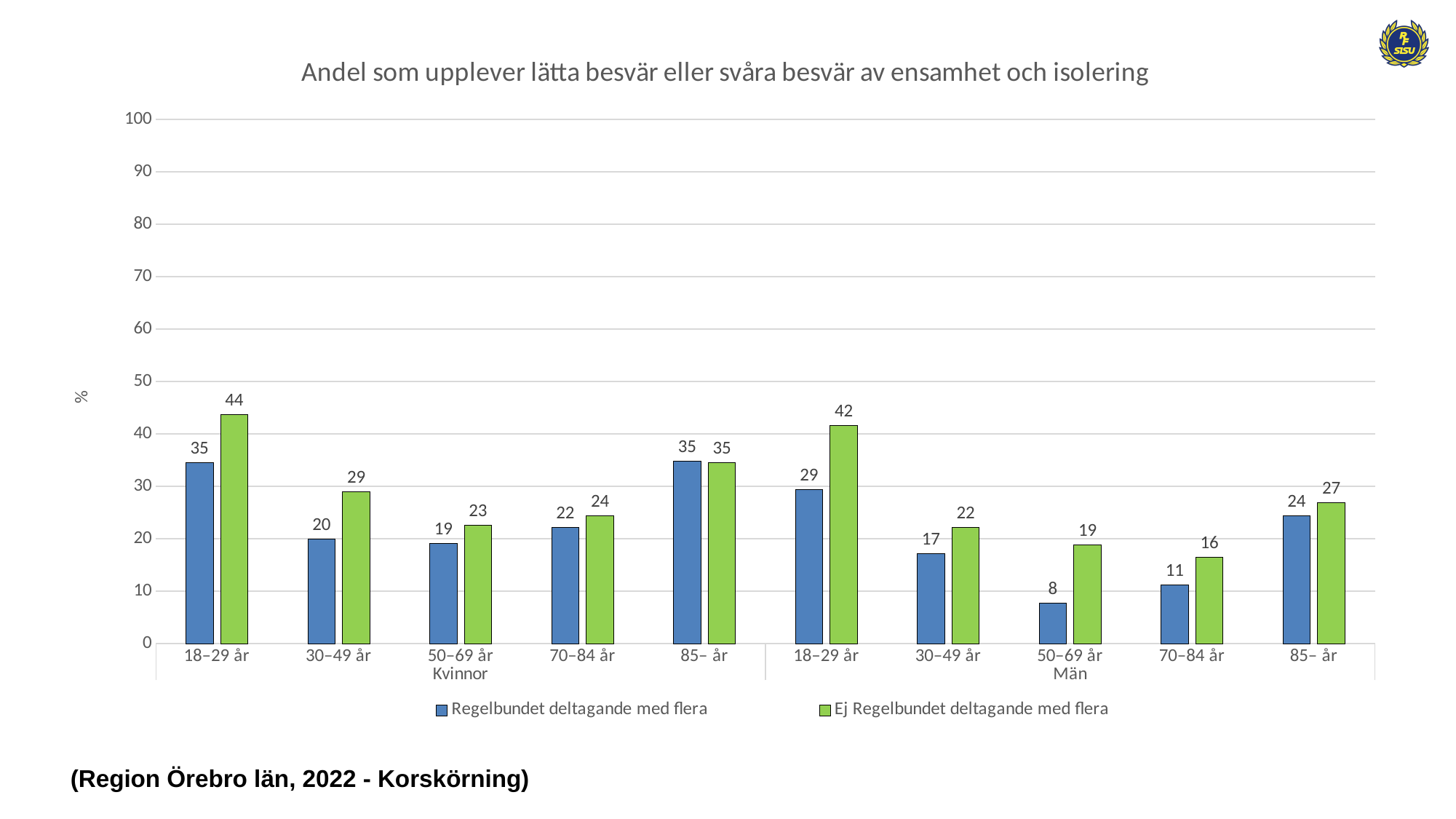
For Kvinnor aged 30–49 år, which series has the larger value? Ej Regelbundet deltagande med flera What colour are the bars for 'Ej Regelbundet deltagande med flera'? green Which group has the highest value for 'Ej Regelbundet deltagande med flera'? Kvinnor 18–29 år What kind of chart is shown on the slide? bar chart How many series does the legend list? 2 How many age groups are shown on the x axis in total? 10 What is the difference between 'Ej Regelbundet deltagande med flera' and 'Regelbundet deltagande med flera' for Män aged 18–29 år? 13 Is the value for 'Regelbundet deltagande med flera' for Män aged 70–84 år greater or less than 20? less What is the value for 'Ej Regelbundet deltagande med flera' for Män aged 50–69 år? 19 What is the value for 'Regelbundet deltagande med flera' for Kvinnor aged 18–29 år? 35 What is the title of the chart? Andel som upplever lätta besvär eller svåra besvär av ensamhet och isolering Which group has the lowest value for 'Regelbundet deltagande med flera'? Män 50–69 år